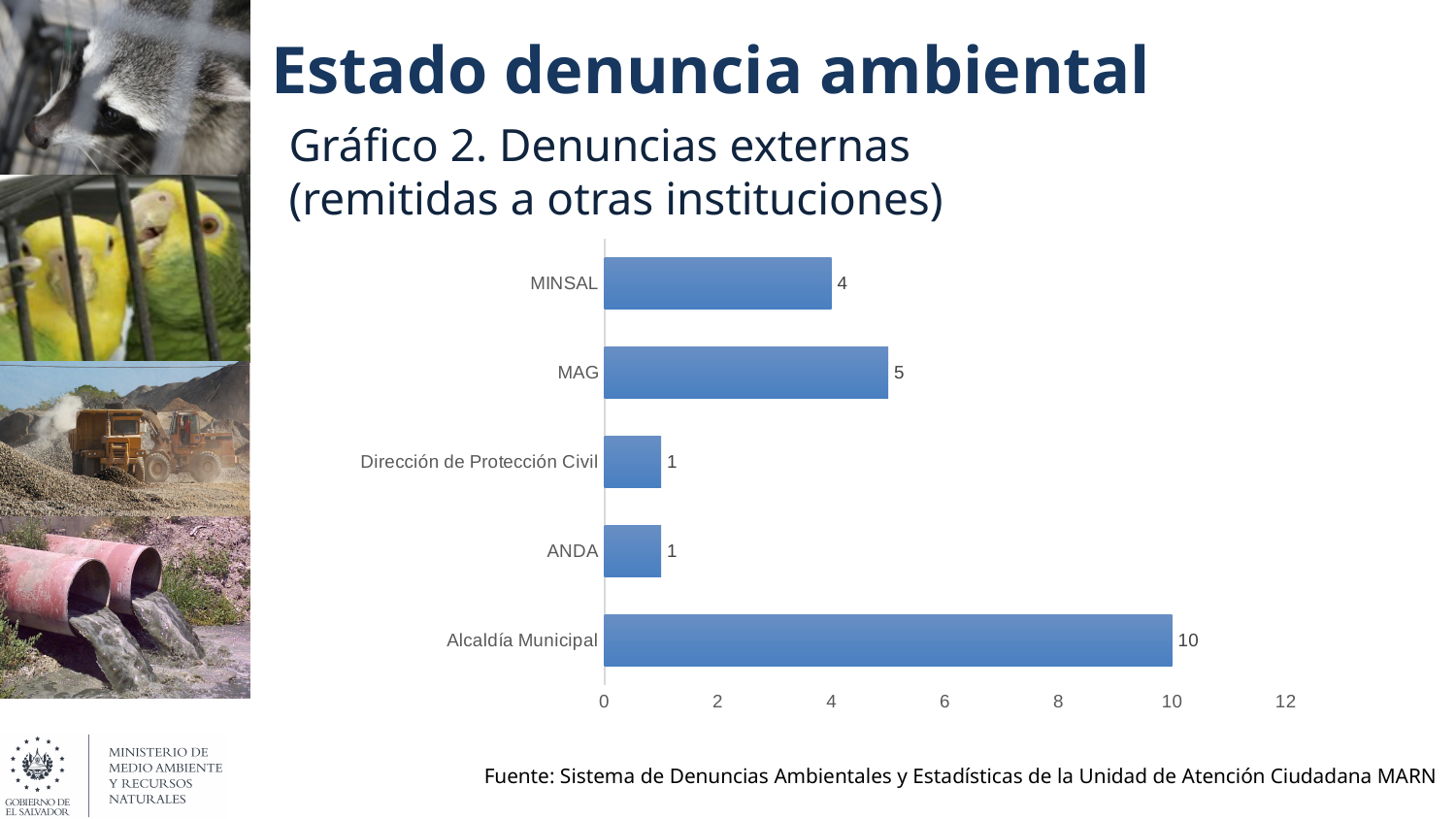
What is the value for Alcaldía Municipal? 10 What is the total of all the values shown in the chart? 21 Which is larger, the value for MAG or the value for MINSAL? MAG What is the value for MINSAL? 4 What is the value for ANDA? 1 How many categories are shown in the chart? 5 Which category has the highest value? Alcaldía Municipal What is the value for MAG? 5 What is the title of the chart? Gráfico 2. Denuncias externas (remitidas a otras instituciones) What kind of chart is shown on the slide? Bar chart What is the difference between the values for Alcaldía Municipal and MAG? 5 Is the value for Alcaldía Municipal greater or less than 8? greater